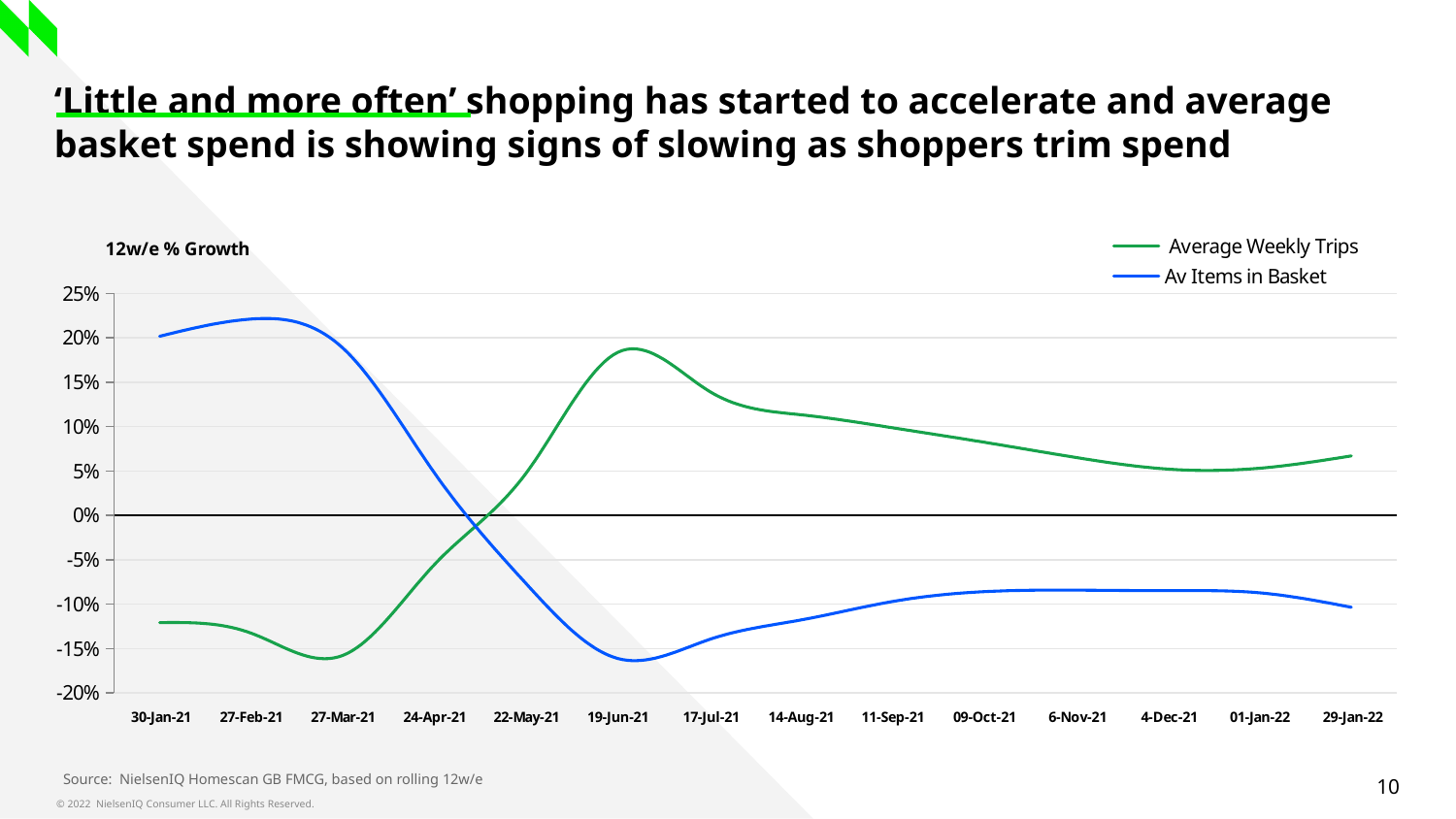
Which colour is used for the Av Items in Basket line? Blue At which date does Av Items in Basket reach its lowest value? 19-Jun-21 Is the value for Av Items in Basket at 19-Jun-21 greater or less than -10%? less At which date does Average Weekly Trips reach its highest value? 19-Jun-21 Is the value for Average Weekly Trips at 27-Mar-21 greater or less than -10%? less How many dates are shown along the x axis? 14 Does the Av Items in Basket line rise or fall between 27-Feb-21 and 19-Jun-21? Fall What is the title shown above the chart's y axis? 12w/e % Growth Is the value for Av Items in Basket at 30-Jan-21 greater or less than 15%? greater What kind of chart is shown on the slide? Line chart At 29-Jan-22, which series has the higher value, Average Weekly Trips or Av Items in Basket? Average Weekly Trips How many series does the legend list? 2